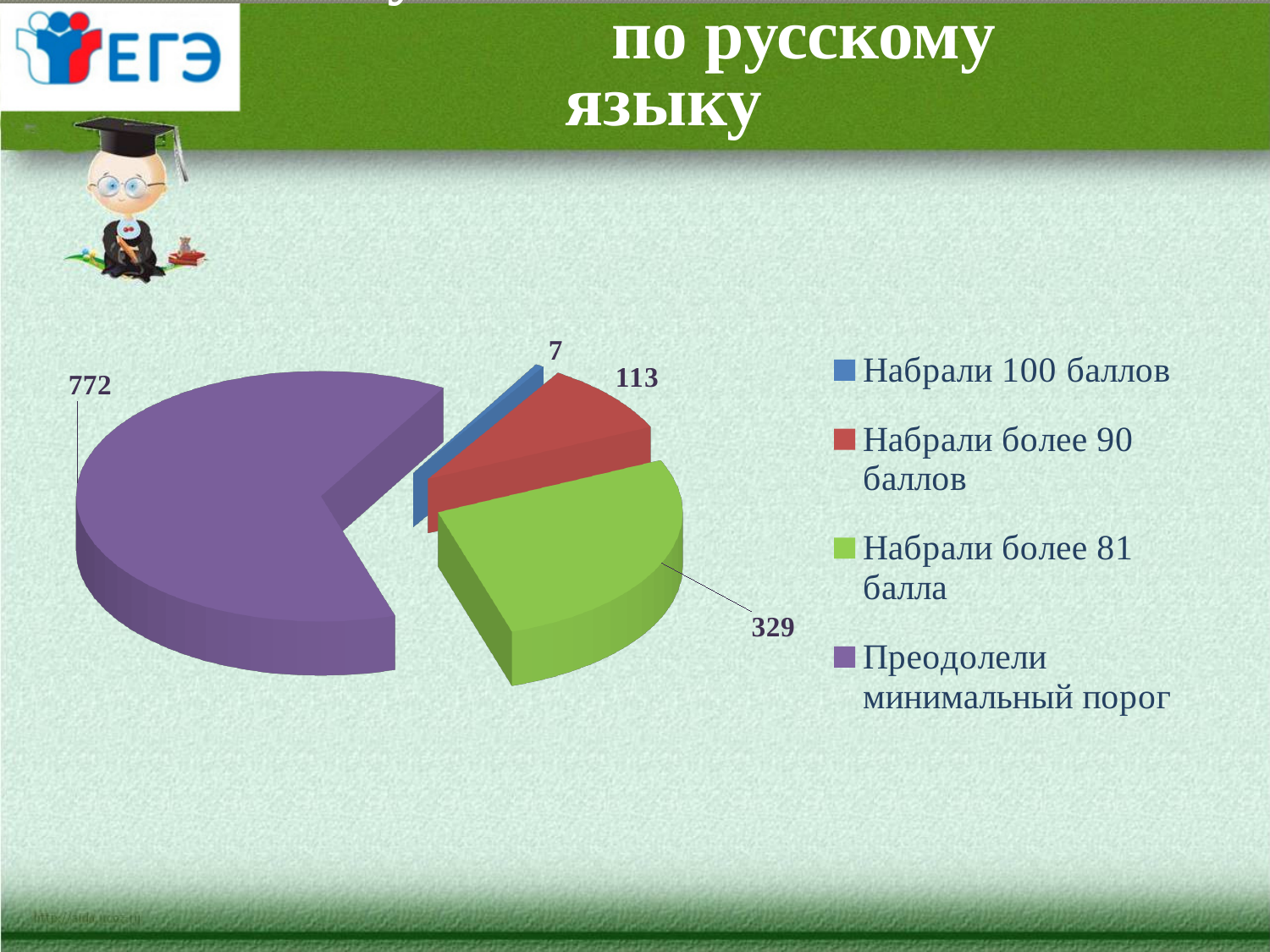
What kind of chart is shown on the slide? Pie chart What is the value for "Набрали более 81 балла"? 329 How many slices does the pie chart have? 4 What is the value for "Набрали более 90 баллов"? 113 Which category has the largest slice of the pie? Преодолели минимальный порог What is the value for "Преодолели минимальный порог"? 772 What colour is the slice for "Набрали более 81 балла"? Green What is the value for "Набрали 100 баллов"? 7 What is the difference between the values for "Преодолели минимальный порог" and "Набрали более 81 балла"? 443 Which is larger: the value for "Набрали более 90 баллов" or the value for "Набрали более 81 балла"? Набрали более 81 балла How many entries does the legend of the pie chart list? 4 Which category has the smallest slice of the pie? Набрали 100 баллов